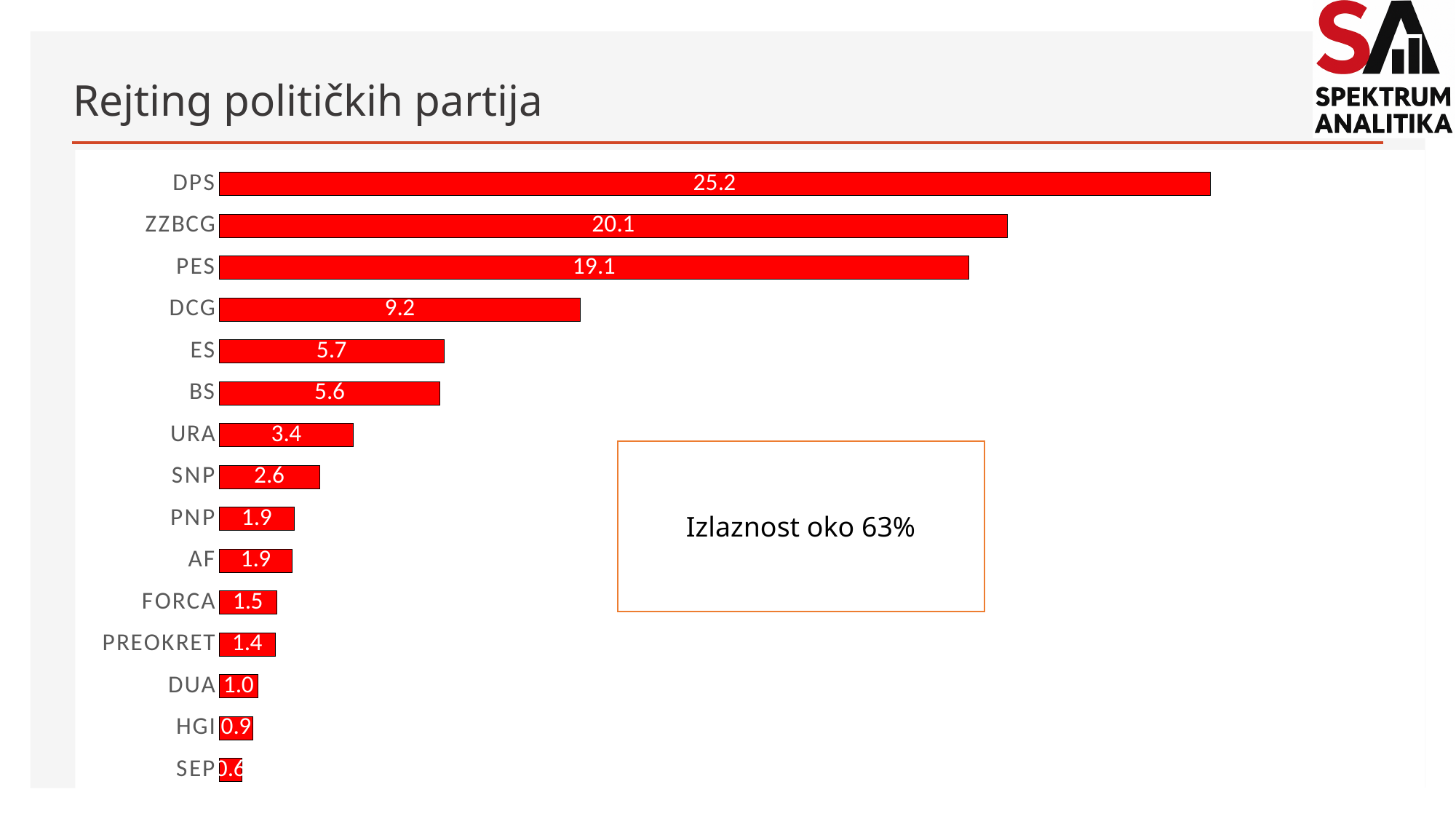
Which party has the lowest value? SEP What is the difference between the values for DCG and SNP? 6.6 What is the value for DPS? 25.2 What kind of chart is shown on the slide? Bar chart Which party has the highest value? DPS What is the value for PES? 19.1 How many parties are shown in the chart? 15 Which is larger, the value for FORCA or the value for DUA? FORCA What is the value for URA? 3.4 What is the difference between the values for DPS and ZZBCG? 5.1 What is the title of the slide? Rejting političkih partija Which is larger, the value for ZZBCG or the value for PES? ZZBCG